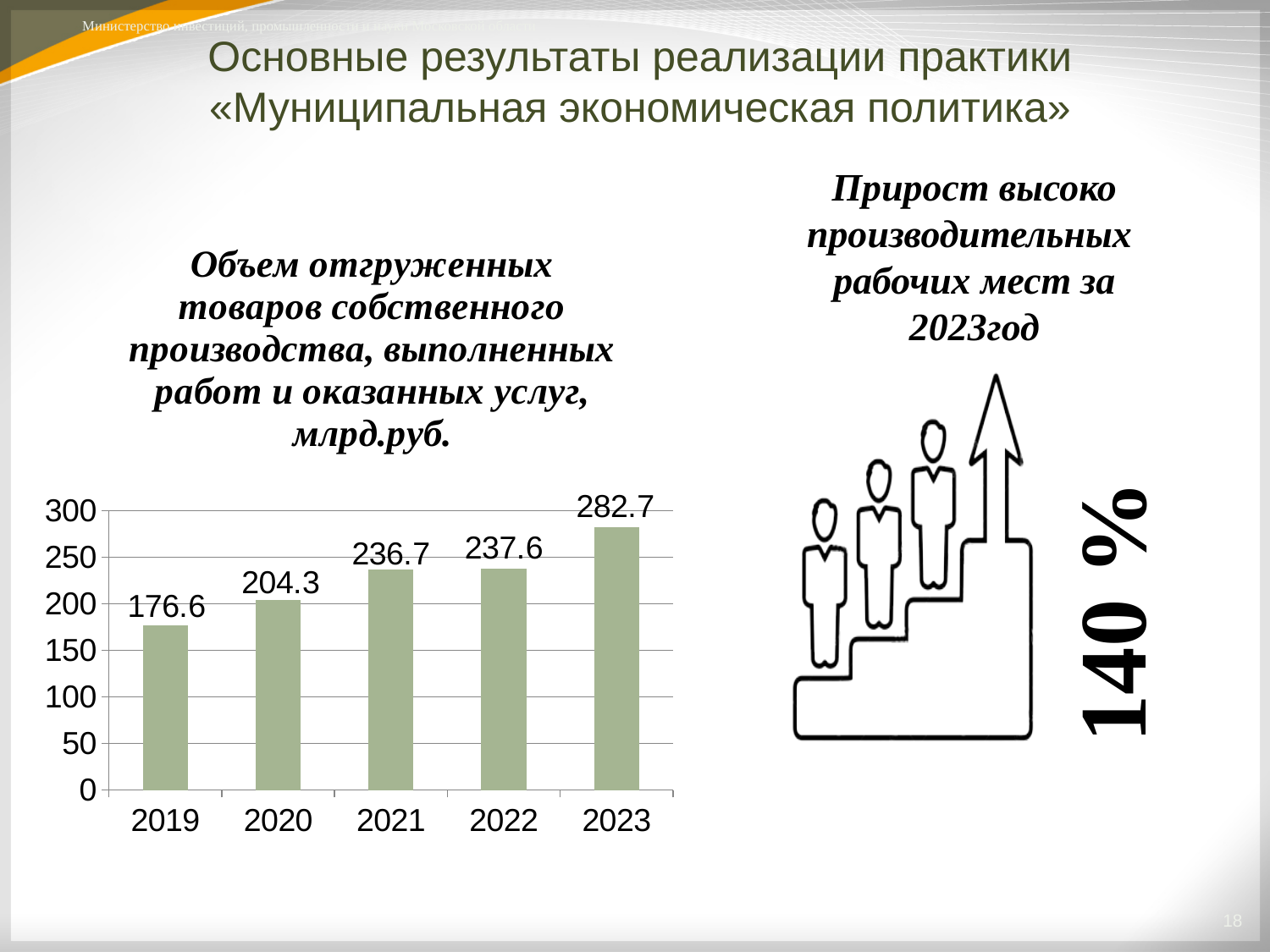
What is the difference between the values for 2023 and 2019 in the bar chart? 106.1 What kind of chart is shown on the slide? bar chart What is the difference between the values for 2020 and 2019 in the bar chart? 27.7 What is the value for 2019 in the bar chart? 176.6 Which year has the highest value in the bar chart? 2023 Which is larger in the bar chart, the value for 2020 or the value for 2022? 2022 What is the value for 2021 in the bar chart? 236.7 What is the value for 2023 in the bar chart? 282.7 How many years are shown on the x axis of the bar chart? 5 Which year has the lowest value in the bar chart? 2019 Is the value for 2022 in the bar chart greater or less than 200? greater Do the values in the bar chart rise or fall from 2019 to 2023? rise